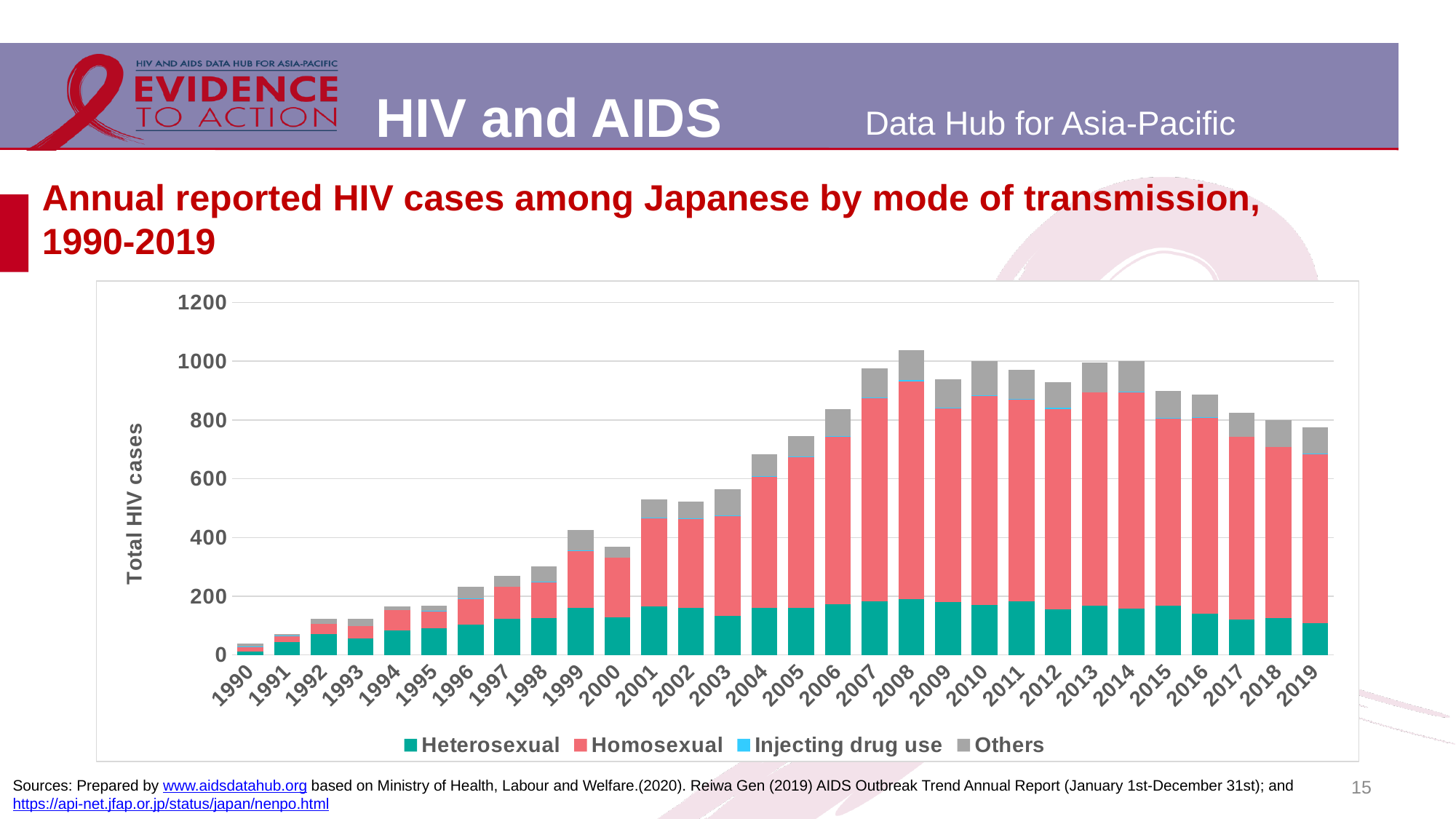
Which year has the lowest total of reported HIV cases? 1990 Is the total number of HIV cases in 2019 greater or less than 800? less What kind of chart is shown on the slide? Stacked bar chart Is the total number of HIV cases in 2008 greater or less than 1000? greater Is the total number of HIV cases in 2001 greater or less than 400? greater How many years (categories) are plotted along the x axis? 30 Do the total reported HIV cases rise or fall from 2014 to 2019? fall What is the label on the y axis of the chart? Total HIV cases Which year has the highest total of reported HIV cases? 2008 Which year has a larger total of HIV cases, 2000 or 2001? 2001 How many series does the legend list? 4